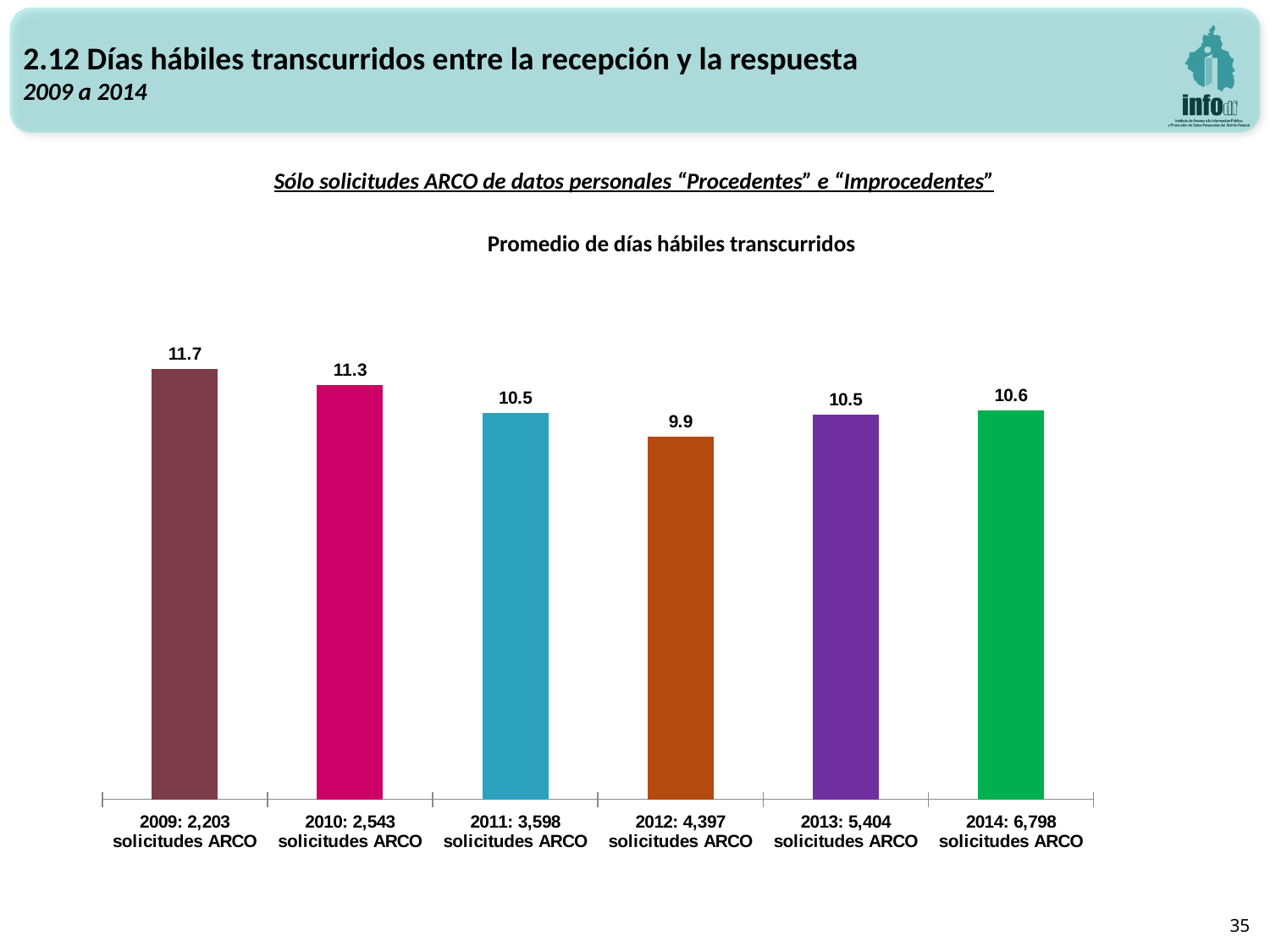
How many years are shown in the chart? 6 Do the values rise or fall from 2009 to 2012? Fall How many solicitudes ARCO are indicated for 2014 in the category label? 6,798 What is the average number of business days elapsed for 2009? 11.7 Which is larger, the average business days for 2010 or for 2014? 2010 What is the average number of business days elapsed for 2012? 9.9 What is the difference between the average business days for 2010 and 2011? 0.8 What kind of chart is shown on the slide? Bar chart What is the difference between the average business days for 2009 and 2012? 1.8 Which year has the highest average number of business days elapsed? 2009 Which year has the lowest average number of business days elapsed? 2012 What is the average number of business days elapsed for 2014? 10.6